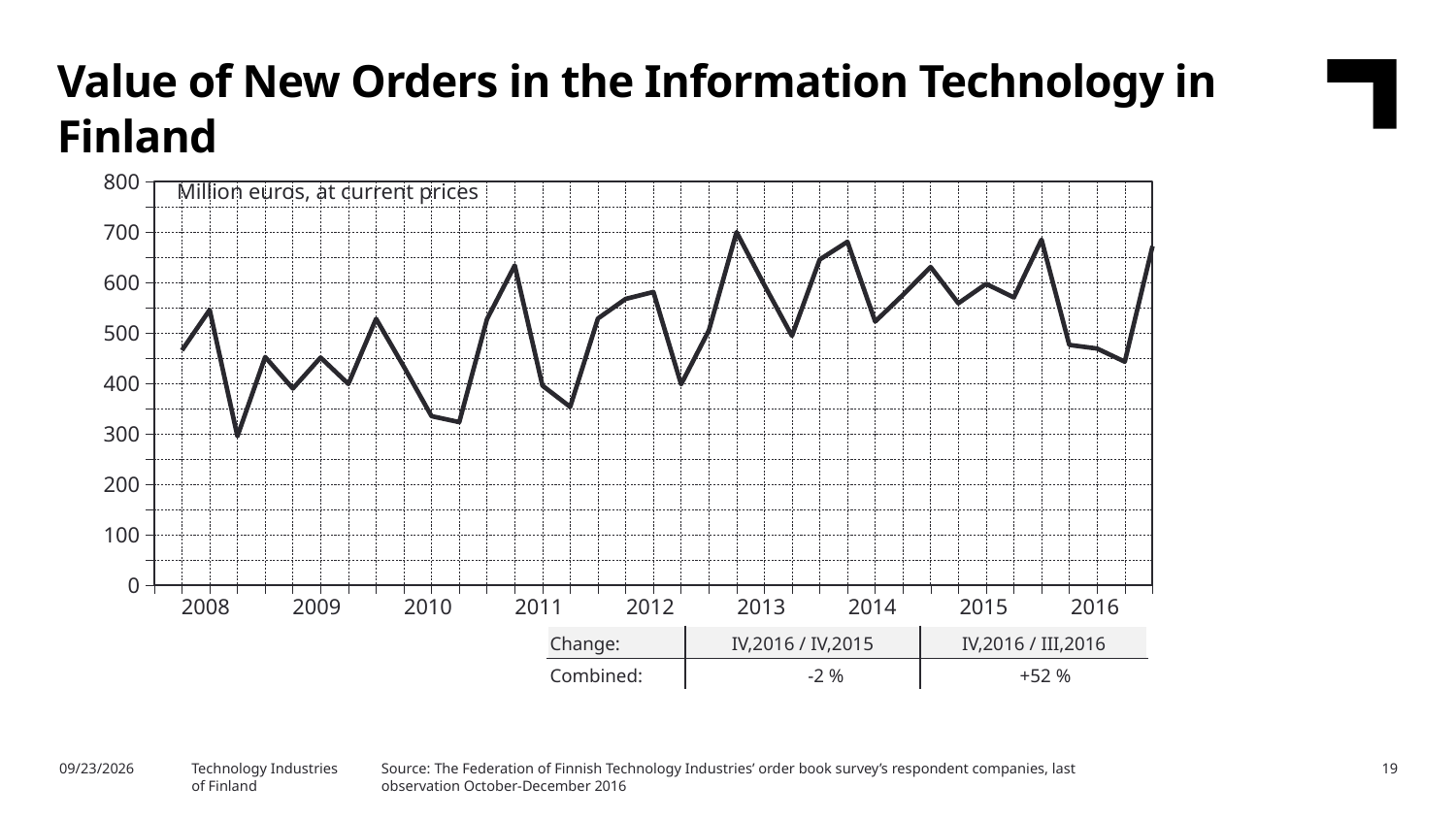
How many years are labelled on the x axis of the chart? 9 In what unit are the values on the chart expressed, according to the label inside the plot area? Million euros, at current prices What kind of chart is shown on the slide? line chart What is the combined change for IV,2016 / III,2016 shown in the table below the chart? +52 % In which year does the line reach its lowest point? 2008 What is the combined change for IV,2016 / IV,2015 shown in the table below the chart? -2 % Is the low point of the line in 2010 greater or less than 400? less Is the last plotted value in 2016 greater or less than 600? greater What is the highest value shown on the y axis of the chart? 800 Is the peak of the line in 2013 greater or less than 600? greater What is the title of the chart? Value of New Orders in the Information Technology in Finland